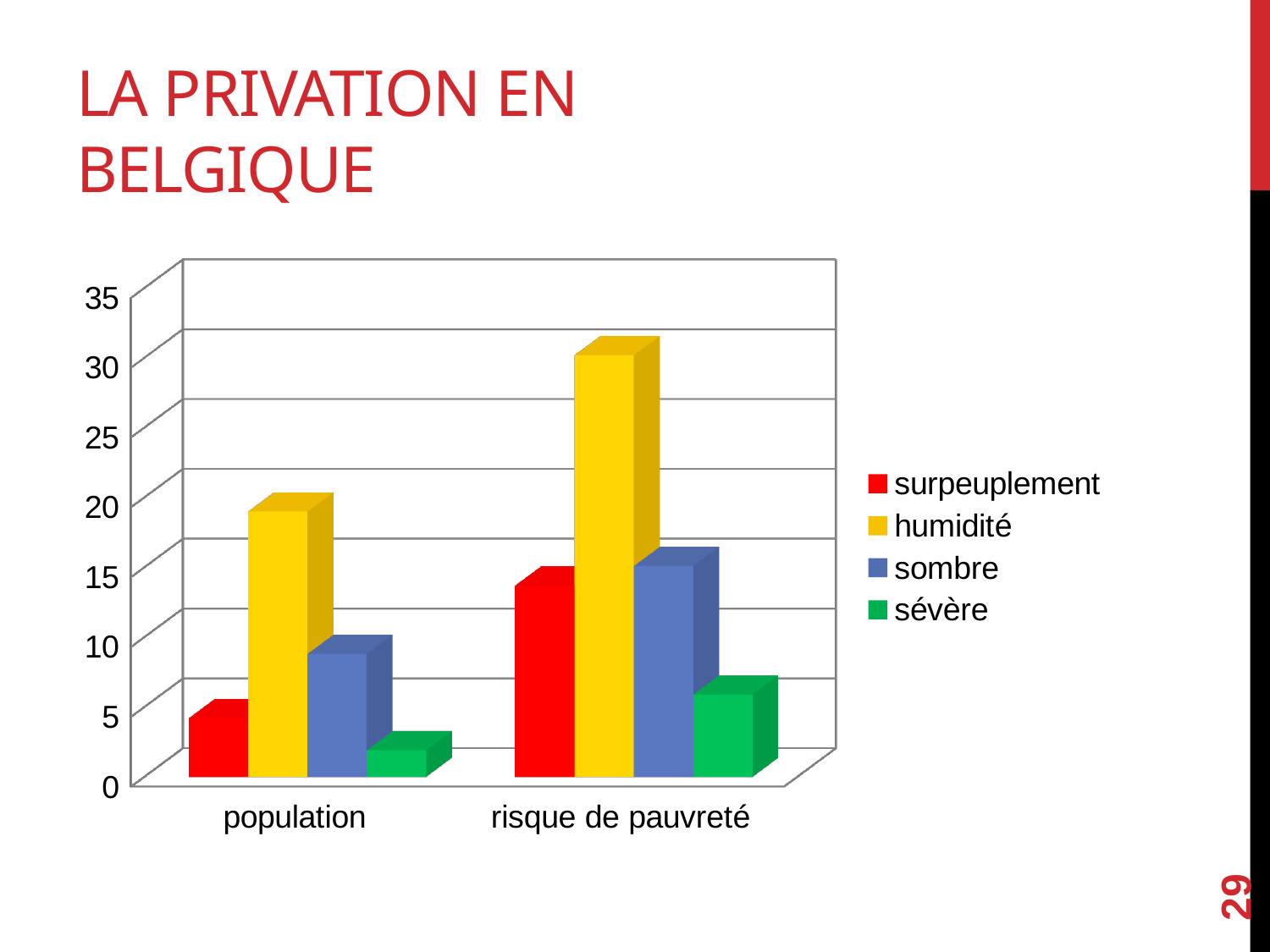
Which series has the lowest value for population? sévère Is the value for sombre in the population category greater or less than 15? less How many categories are shown on the x axis? 2 What kind of chart is shown on the slide? bar chart What colour represents the sombre series in the legend? blue Which is larger for the population category: humidité or surpeuplement? humidité Do the values for humidité rise or fall from population to risque de pauvreté? rise Which series has the highest value for risque de pauvreté? humidité Is the value for sévère in the population category greater or less than 5? less Is the value for humidité in the risque de pauvreté category greater or less than 25? greater How many series does the legend list? 4